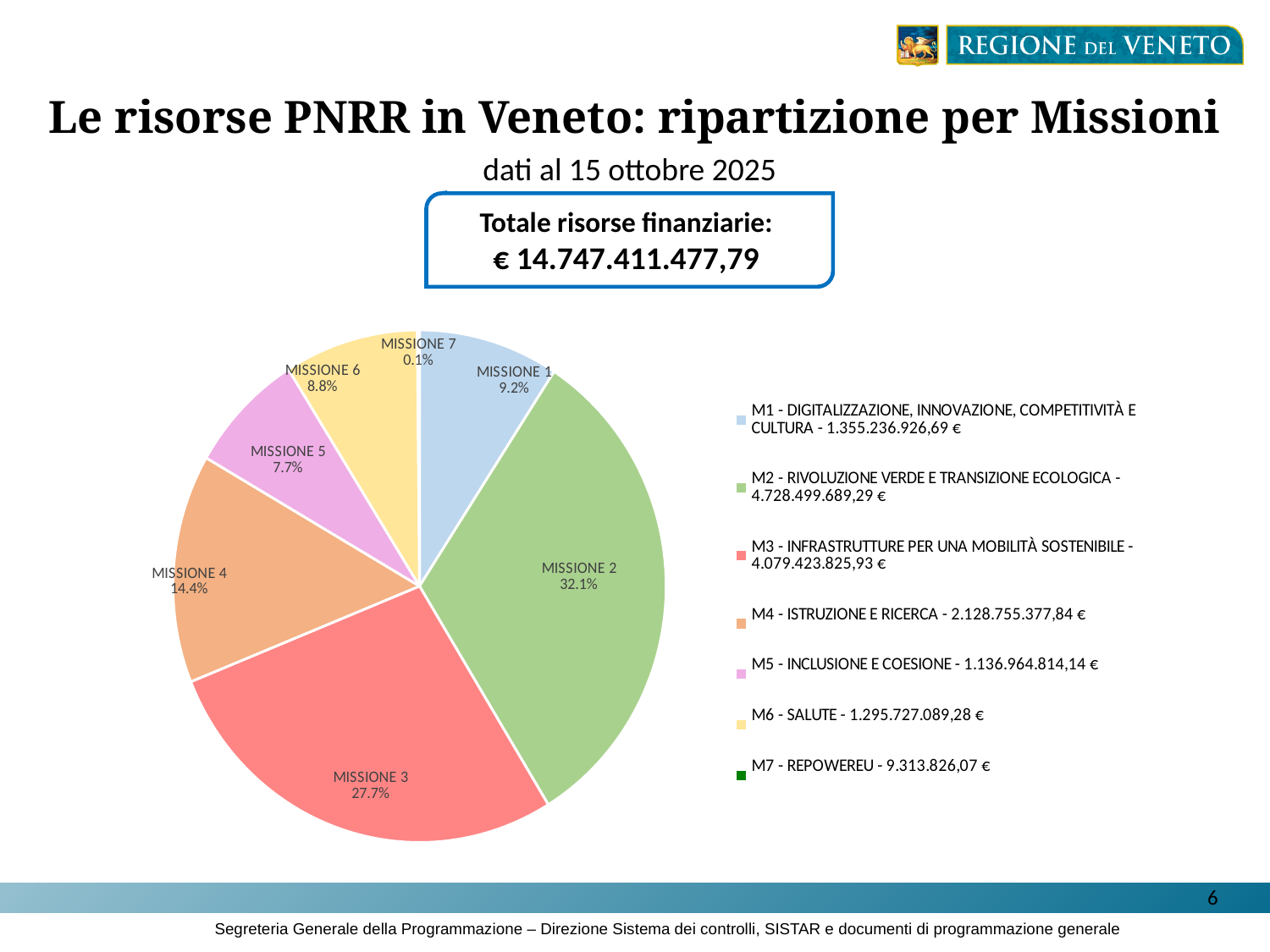
What percentage is shown for MISSIONE 4? 14.4% What percentage is shown for MISSIONE 7? 0.1% Which mission has the largest slice of the pie? MISSIONE 2 Which mission has the smallest slice of the pie? MISSIONE 7 What kind of chart is shown on the slide? pie chart Which has a larger share, MISSIONE 5 or MISSIONE 6? MISSIONE 6 What total financial resources figure is shown in the box above the chart? € 14.747.411.477,79 What share of the pie does MISSIONE 2 represent? 32.1% What is the difference in percentage points between MISSIONE 2 and MISSIONE 3? 4.4% According to the legend, what amount is listed for M6 - SALUTE? 1.295.727.089,28 € What is the difference in percentage points between MISSIONE 4 and MISSIONE 6? 5.6% How many slices does the pie chart have? 7